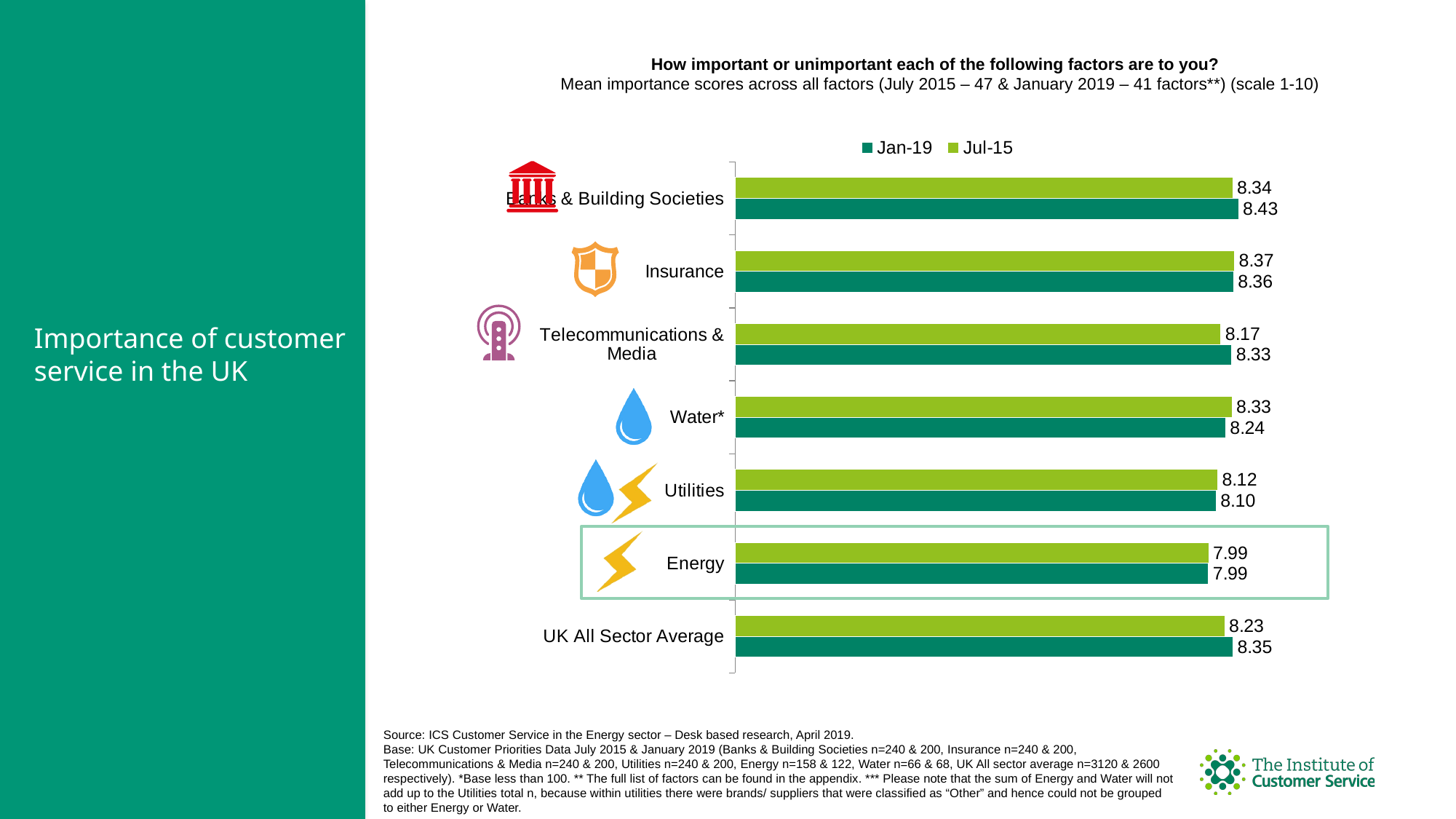
For Water*, which is larger: the Jul-15 score or the Jan-19 score? Jul-15 Which category has the highest Jan-19 score? Banks & Building Societies Which series is shown in dark green in the legend? Jan-19 How many series does the legend list? 2 What is the Jul-15 score for Energy? 7.99 How many categories are shown on the chart? 7 Which sector has the lowest Jan-19 score? Energy What is the Jul-15 mean importance score for Telecommunications & Media? 8.17 What type of chart is shown on the slide? Bar chart What is the Jan-19 mean importance score for Banks & Building Societies? 8.43 What is the Jan-19 value for the UK All Sector Average? 8.35 What is the difference between the Jan-19 and Jul-15 scores for Telecommunications & Media? 0.16